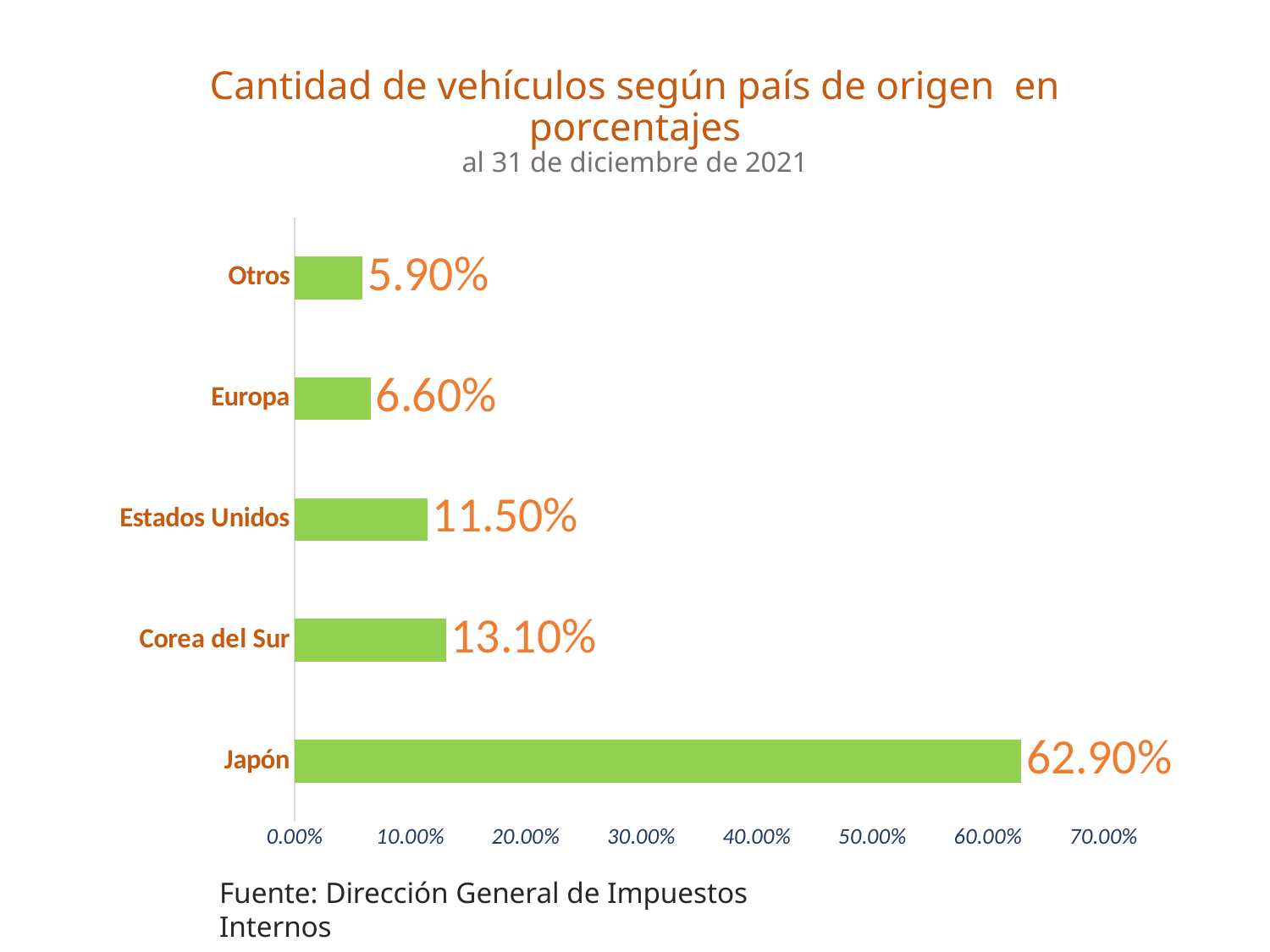
Which category has the highest value? Japón What is the value for Estados Unidos? 11.50% What kind of chart is shown on the slide? bar chart What is the difference between the values for Japón and Corea del Sur? 49.80% What is the value for Europa? 6.60% Which category has the lowest value? Otros What is the value for Japón? 62.90% Which is larger, the value for Estados Unidos or the value for Europa? Estados Unidos Is the value for Japón greater or less than 60.00%? greater What is the value for Corea del Sur? 13.10% What is the value for Otros? 5.90% How many categories are shown in the chart? 5